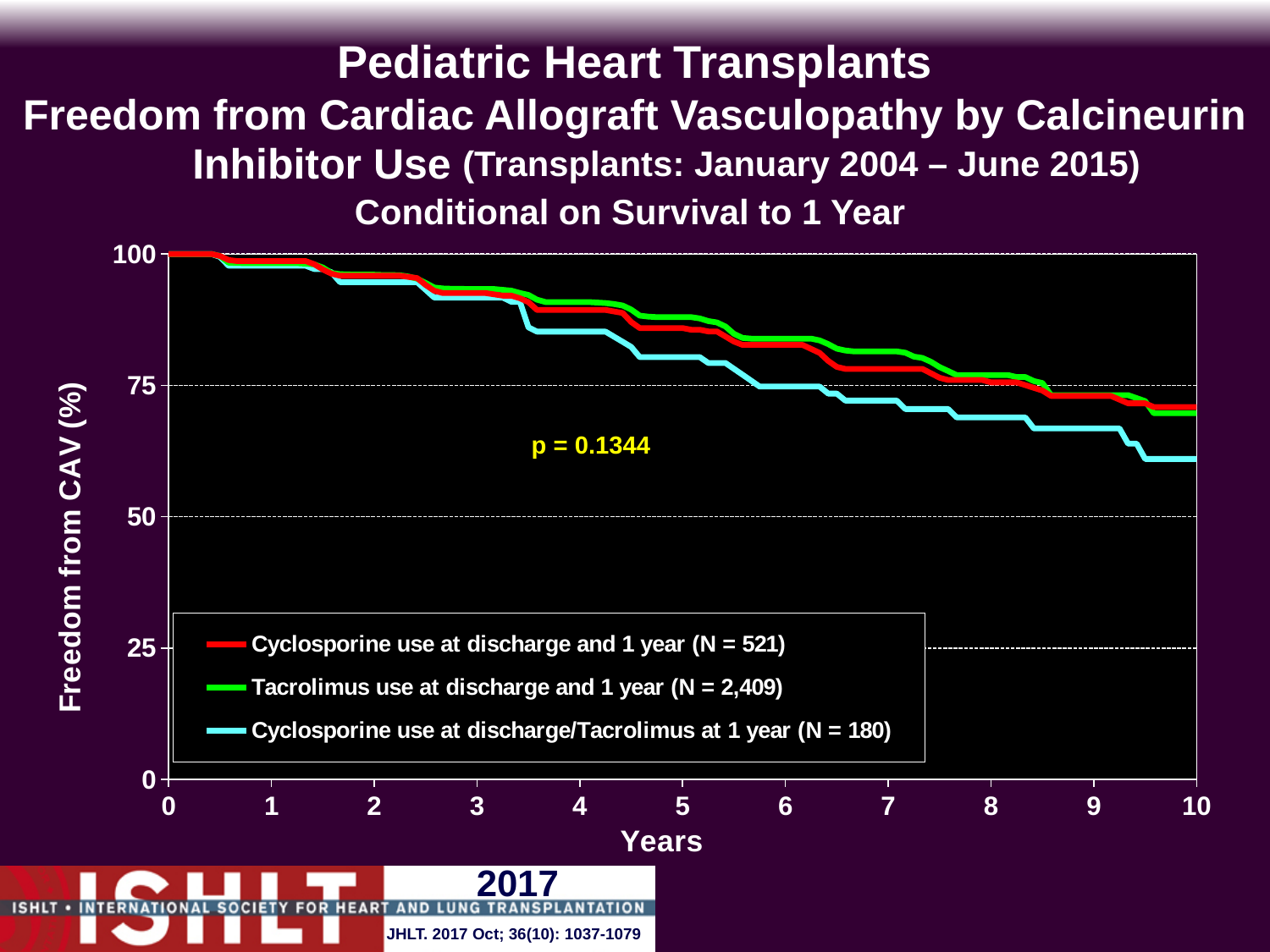
At 10 years, which series has the lowest freedom from CAV? Cyclosporine use at discharge/Tacrolimus at 1 year How many series does the legend list? 3 Is the value for the Cyclosporine use at discharge and 1 year series at 5 years greater or less than 75? greater Is the value for the Tacrolimus use at discharge and 1 year series at 10 years greater or less than 75? less At 10 years, which is larger: the value for the Tacrolimus use at discharge and 1 year series or the Cyclosporine use at discharge/Tacrolimus at 1 year series? Tacrolimus use at discharge and 1 year What is the N for the Tacrolimus use at discharge and 1 year series in the legend? 2,409 What kind of chart is shown on the slide? Line chart Is the value for the Cyclosporine use at discharge/Tacrolimus at 1 year series at 10 years greater or less than 75? less Do the values for freedom from CAV rise or fall as years increase? Fall What p-value is printed on the chart? p = 0.1344